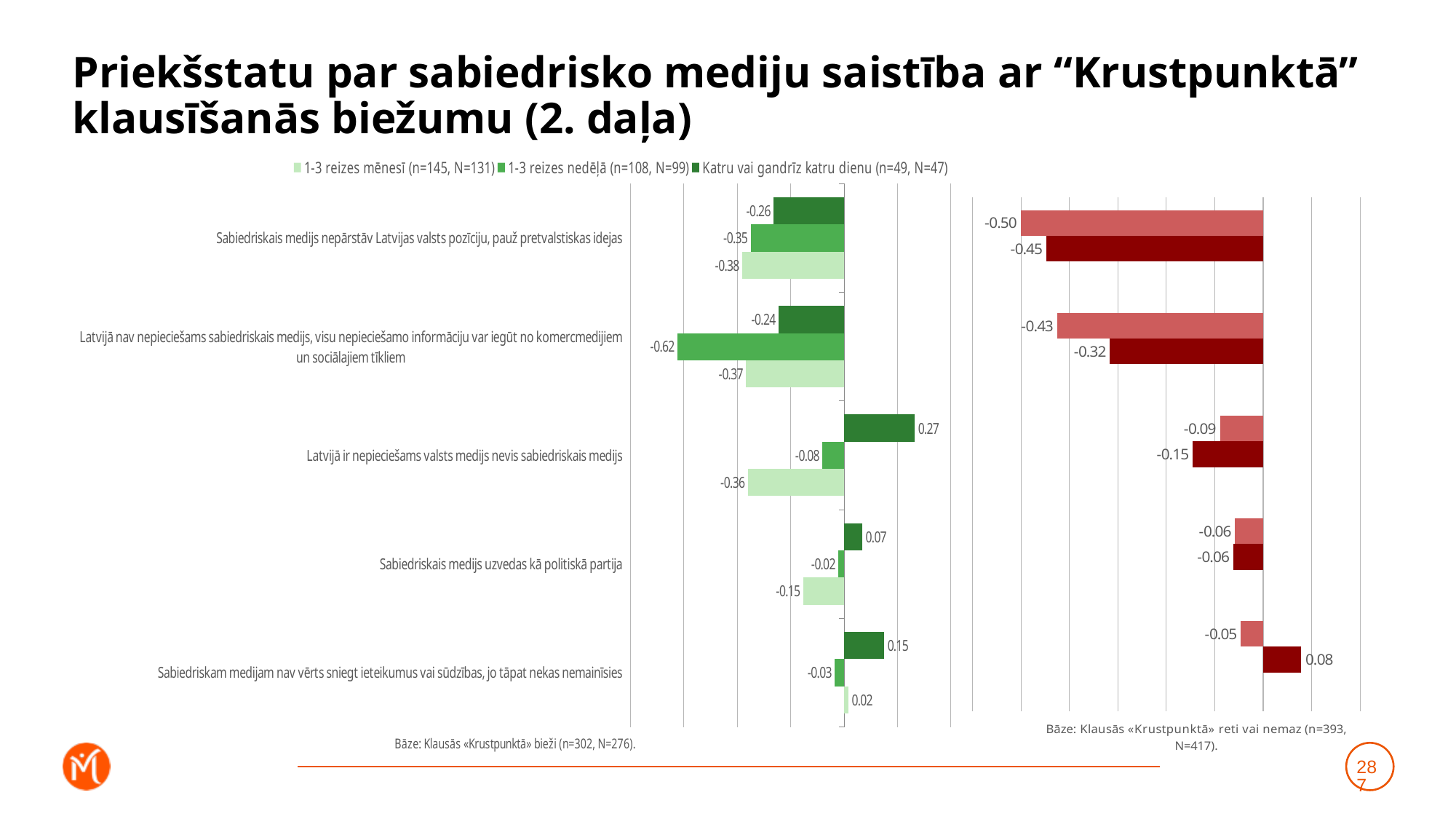
In the left (green) chart, which statement has the highest value for the "Katru vai gandrīz katru dienu" series? Latvijā ir nepieciešams valsts medijs nevis sabiedriskais medijs What kind of chart is the left (green) chart? Bar chart In the left (green) chart, what is the value for "1-3 reizes mēnesī" for the statement "Sabiedriskais medijs uzvedas kā politiskā partija"? -0.15 How many series does the legend list for the left (green) chart? 3 In the left (green) chart, what is the value for "Katru vai gandrīz katru dienu" for the statement "Latvijā ir nepieciešams valsts medijs nevis sabiedriskais medijs"? 0.27 In the right (red) chart, what is the only positive value shown? 0.08 In the left (green) chart, which statement has the lowest value for the "1-3 reizes nedēļā" series? Latvijā nav nepieciešams sabiedriskais medijs, visu nepieciešamo informāciju var iegūt no komercmedijiem un sociālajiem tīkliem In the left (green) chart, what is the difference between the "Katru vai gandrīz katru dienu" value (0.27) and the "1-3 reizes mēnesī" value (-0.36) for "Latvijā ir nepieciešams valsts medijs nevis sabiedriskais medijs"? 0.63 In the left (green) chart, what is the value for "1-3 reizes nedēļā" for the statement "Latvijā nav nepieciešams sabiedriskais medijs, visu nepieciešamo informāciju var iegūt no komercmedijiem un sociālajiem tīkliem"? -0.62 In the left (green) chart, for "Sabiedriskais medijs nepārstāv Latvijas valsts pozīciju, pauž pretvalstiskas idejas", which series has the larger value: "Katru vai gandrīz katru dienu" or "1-3 reizes mēnesī"? Katru vai gandrīz katru dienu How many statements (categories) are shown in the left (green) chart? 5 In the right (red) chart, what is the value of the upper (lighter red) bar for the first statement, "Sabiedriskais medijs nepārstāv Latvijas valsts pozīciju, pauž pretvalstiskas idejas"? -0.50